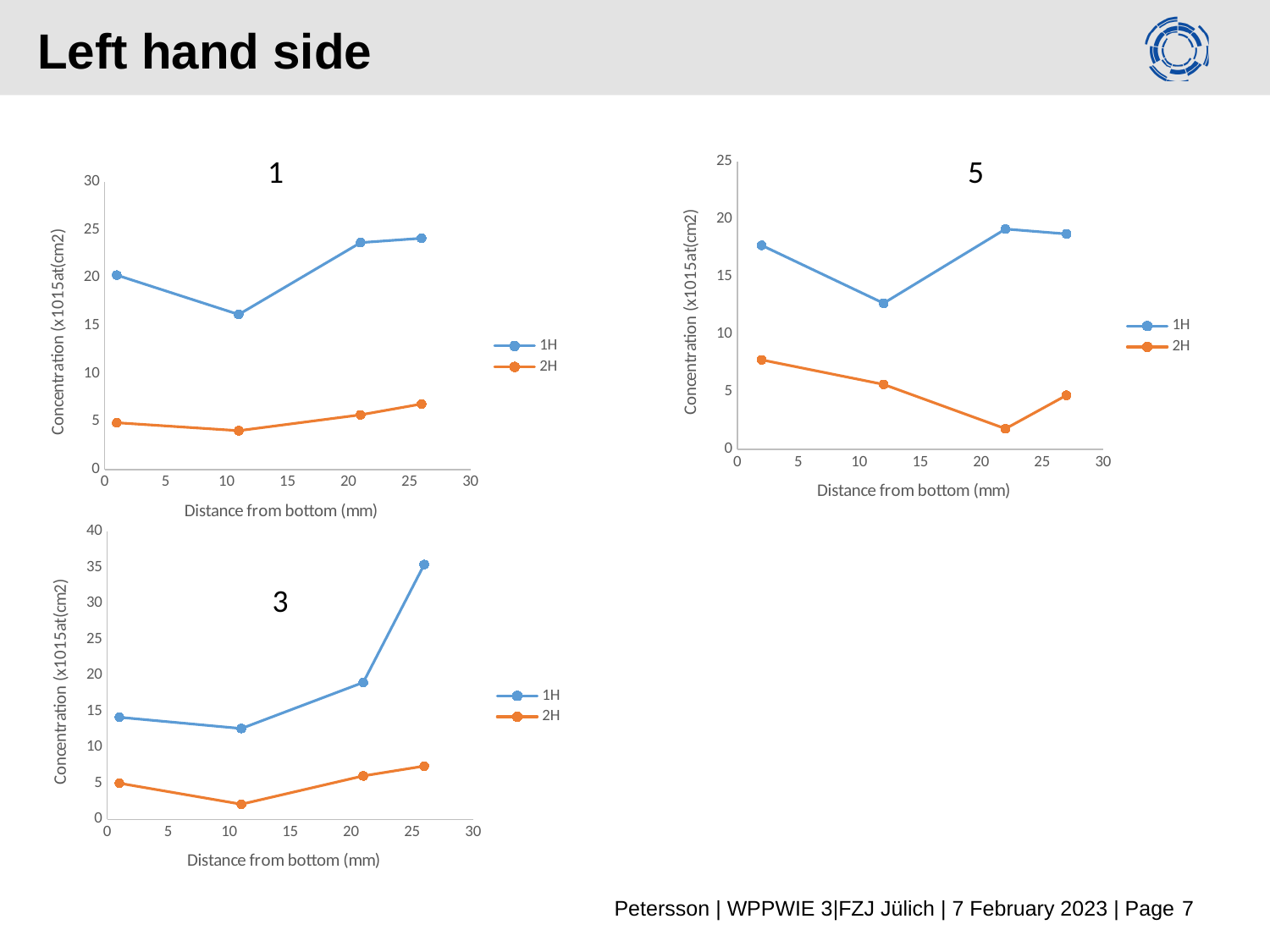
What are the two legend entries in the chart titled "1"? 1H and 2H In the chart titled "3", how many series does the legend list? 2 In the chart titled "5", which series has the higher values across all distances? 1H What is the x-axis label of the chart titled "3"? Distance from bottom (mm) What kind of chart is the chart titled "1"? line chart In the chart titled "5", how many data points does the 1H series have? 4 In the chart titled "1", at about 26 mm, which series has the larger value, 1H or 2H? 1H In the chart titled "5", does the 2H series rise or fall from about 2 mm to about 22 mm? falls In the chart titled "3", is the 1H value at the largest distance (about 26 mm) greater or less than 30? greater In the chart titled "3", does the 1H series rise or fall from about 11 mm to about 26 mm? rises In the chart titled "5", is the 1H value at about 12 mm greater or less than 15? less In the chart titled "1", is the 2H value at about 11 mm greater or less than 5? less